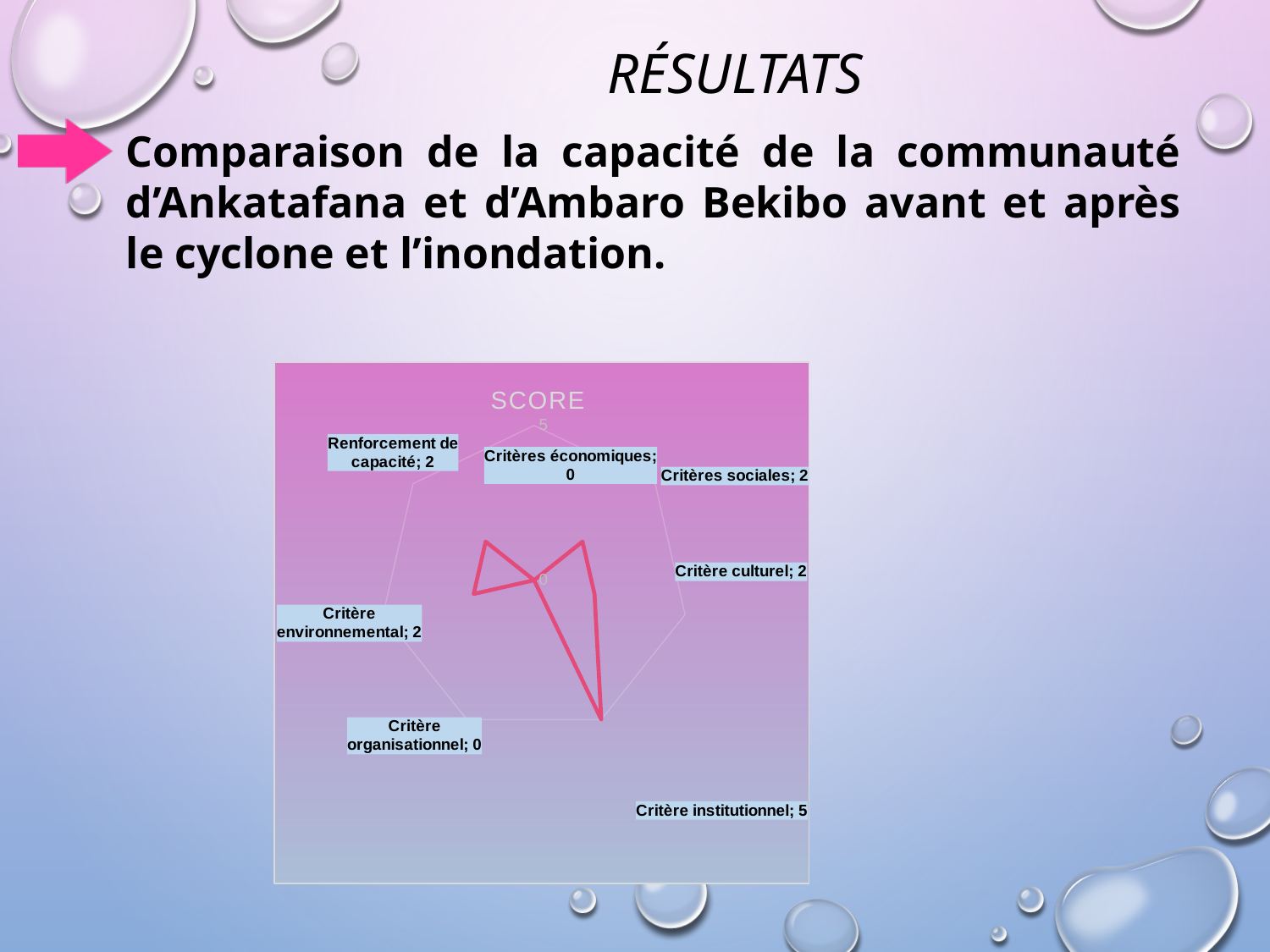
How many categories does the radar chart have? 7 What is the value for Critères économiques? 0 What is the value for Critère organisationnel? 0 What is the maximum value shown on the chart's axis? 5 What is the title of the chart? SCORE What kind of chart is shown on the slide? radar chart What is the value for Critère institutionnel? 5 What is the value for Renforcement de capacité? 2 Which category has the highest value? Critère institutionnel Which is larger, the value for Critère culturel or the value for Critère organisationnel? Critère culturel What is the difference between the values for Critère institutionnel and Critères sociales? 3 What is the value for Critère environnemental? 2